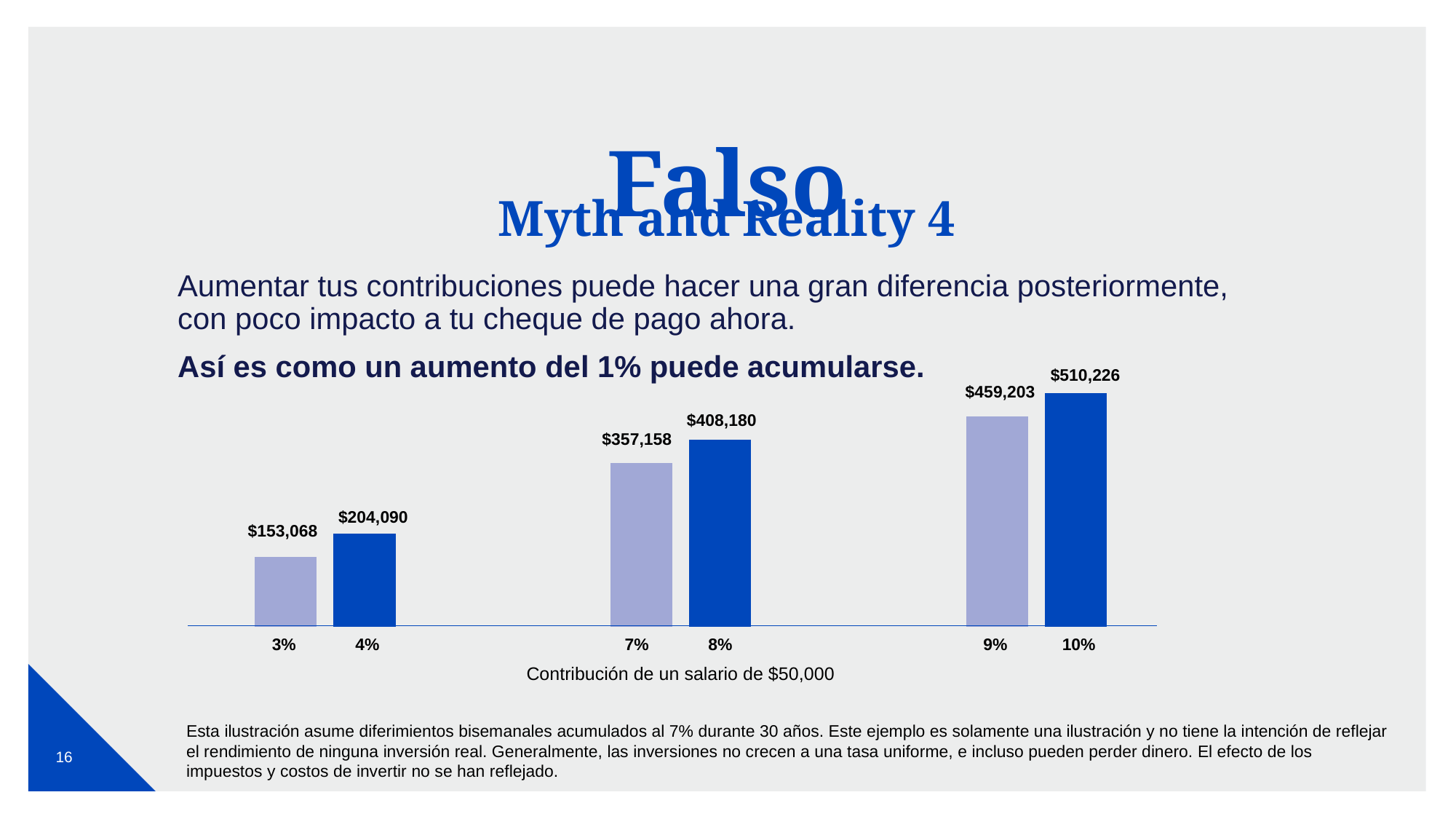
Which contribution rate has the lowest value in the chart? 3% How many bars are plotted in the chart? 6 Which is larger, the value for the 7% bar or the value for the 8% bar? 8% What is the difference between the values for the 4% and 3% contribution bars? $51,022 What is the axis title shown below the contribution rate labels? Contribución de un salario de $50,000 What is the value shown for the 3% contribution bar? $153,068 What is the difference between the values for the 10% and 9% contribution bars? $51,023 What kind of chart is shown on the slide? Bar chart What is the value shown for the 10% contribution bar? $510,226 Which contribution rate has the highest value in the chart? 10% What is the value shown for the 8% contribution bar? $408,180 Do the values rise or fall as the contribution rate increases along the x axis? Rise